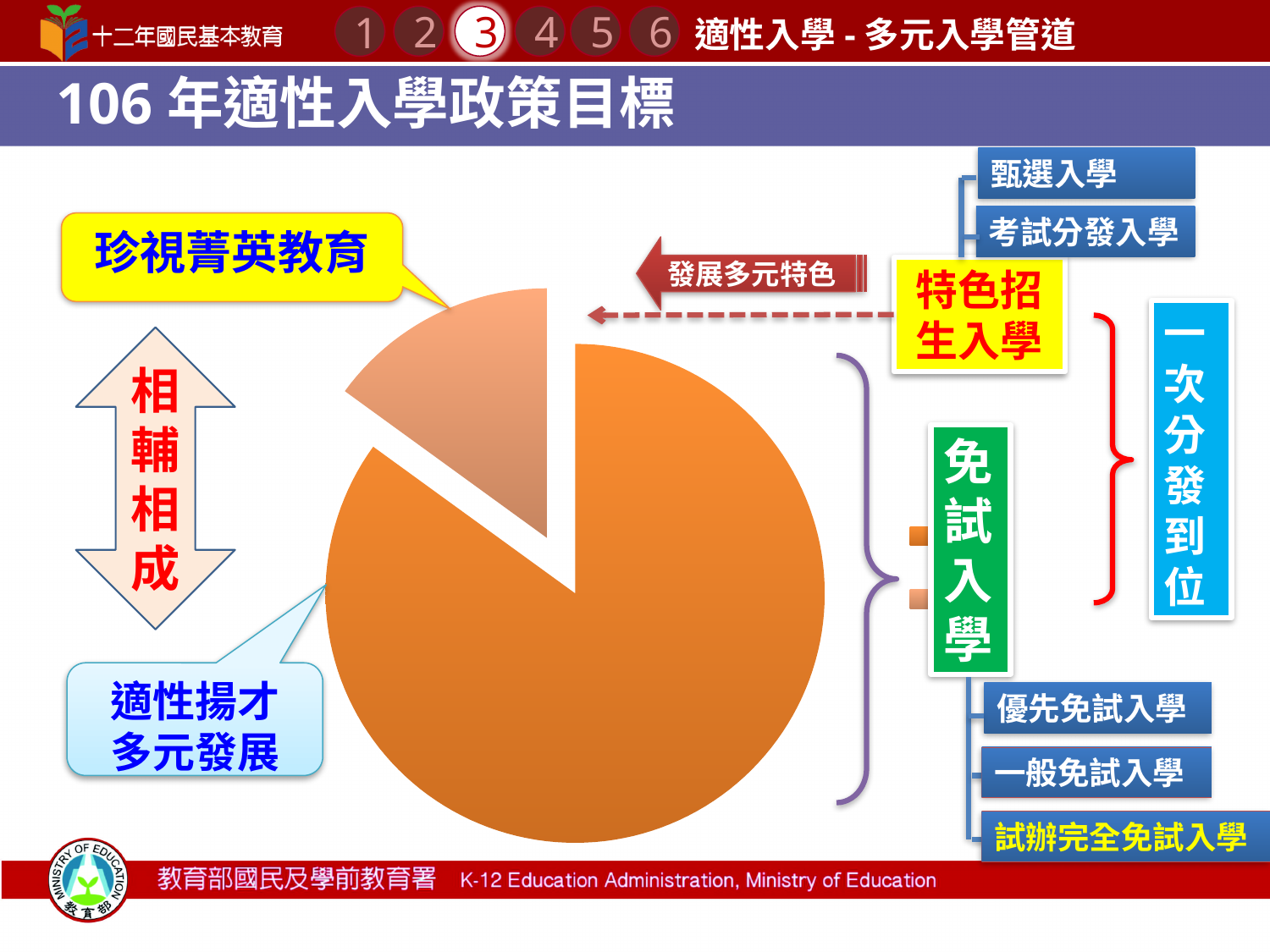
Which is larger in the pie chart, the 免試入學 slice or the 特色招生入學 slice? 免試入學 What is the title of the slide containing the pie chart? 106 年適性入學政策目標 Which slice of the pie chart is the largest? 免試入學 How many slices does the pie chart have? 2 What colour is the large 免試入學 slice of the pie chart? orange Is the 免試入學 slice more or less than half of the pie? more Which slice of the pie chart is the smallest? 特色招生入學 What kind of chart is shown on the slide? pie chart Which slice of the pie chart is pulled out (exploded) from the rest of the pie? 特色招生入學 Is the 特色招生入學 slice more or less than half of the pie? less